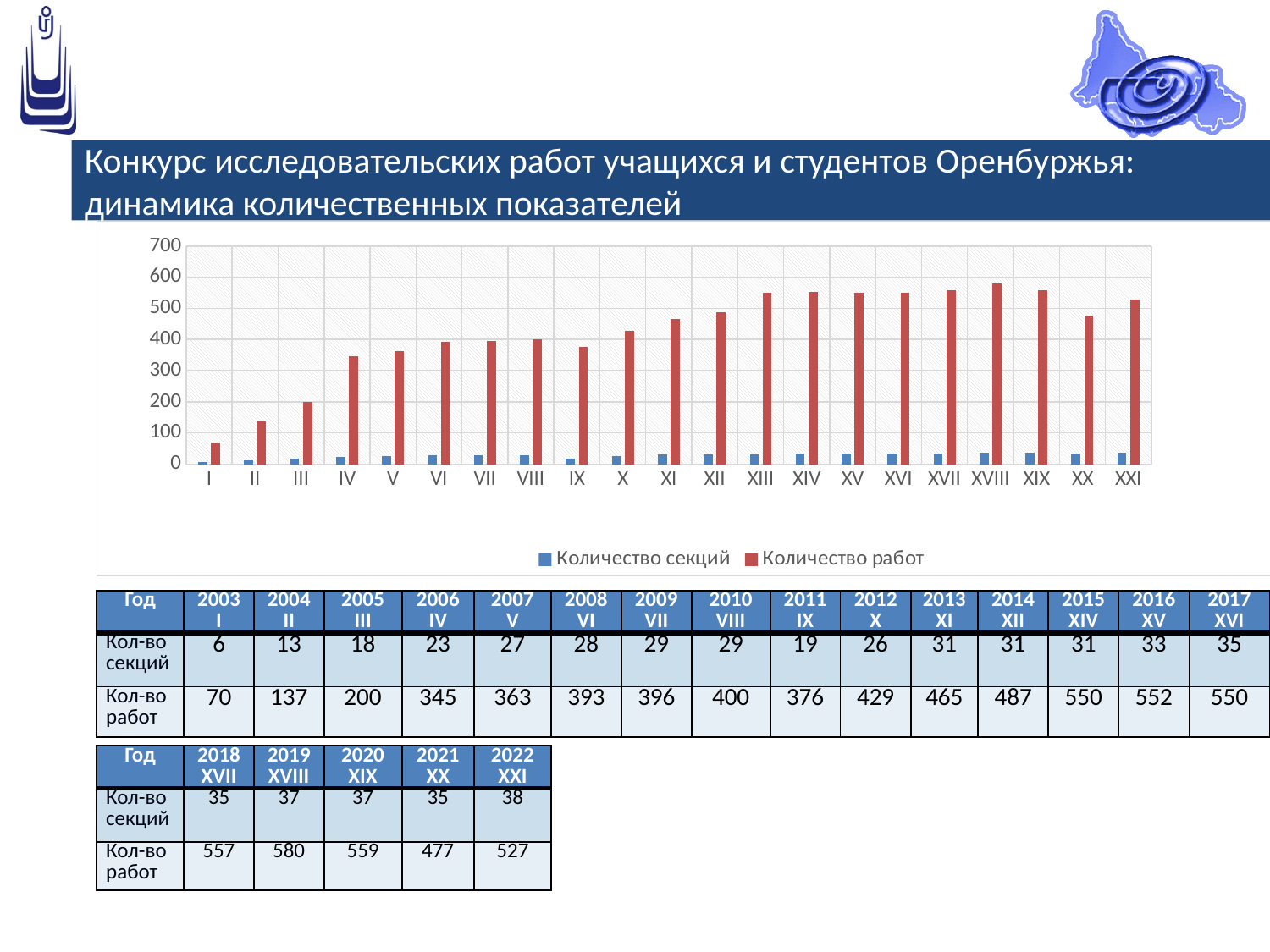
Is the value of Количество работ for category XX greater or less than 500? less What is the value of Количество секций for category XXI? 38 How many categories (competitions) are shown along the x axis of the chart? 21 How many series does the chart legend list? 2 Is the value of Количество работ for category XXI greater or less than 500? greater What is the value of Количество работ for category XVIII? 580 What is the difference between Количество работ for XVIII and for XX? 103 Which category has the highest value for Количество работ? XVIII Which category has the lowest value for Количество работ? I Do the values of Количество работ generally rise or fall from category I to category XVIII? rise Which is larger: Количество работ for XIII or for XX? XIII What kind of chart is shown on the slide? bar chart